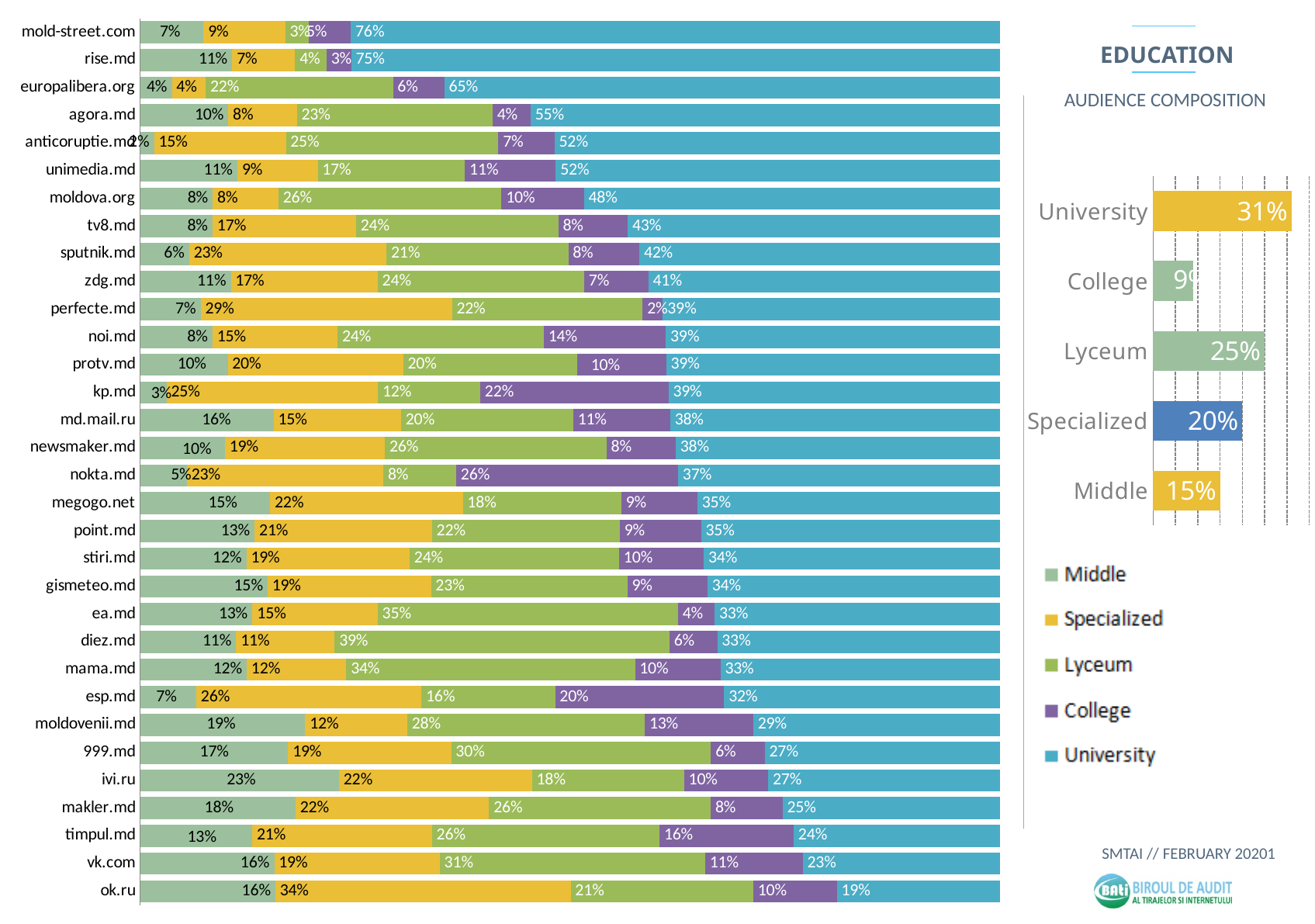
On the left stacked bar chart, which website has the lowest University share? ok.ru On the left stacked bar chart, what is the University share for mold-street.com? 76% On the right 'Education Audience Composition' chart, what is the value for University? 31% How many series does the legend of the left stacked bar chart list? 5 On the left stacked bar chart, what is the College share for nokta.md? 26% On the left stacked bar chart, which has the larger College share: nokta.md or noi.md? nokta.md On the left stacked bar chart, what is the Lyceum share for diez.md? 39% On the left stacked bar chart, what is the Specialized share for ok.ru? 34% On the right 'Education Audience Composition' chart, which category has the lowest value? College On the left stacked bar chart, which website has the highest University share? mold-street.com On the right 'Education Audience Composition' chart, what is the difference between the University and College values? 22 percentage points On the left stacked bar chart, what is the difference between the University share of mold-street.com and that of ok.ru? 57 percentage points